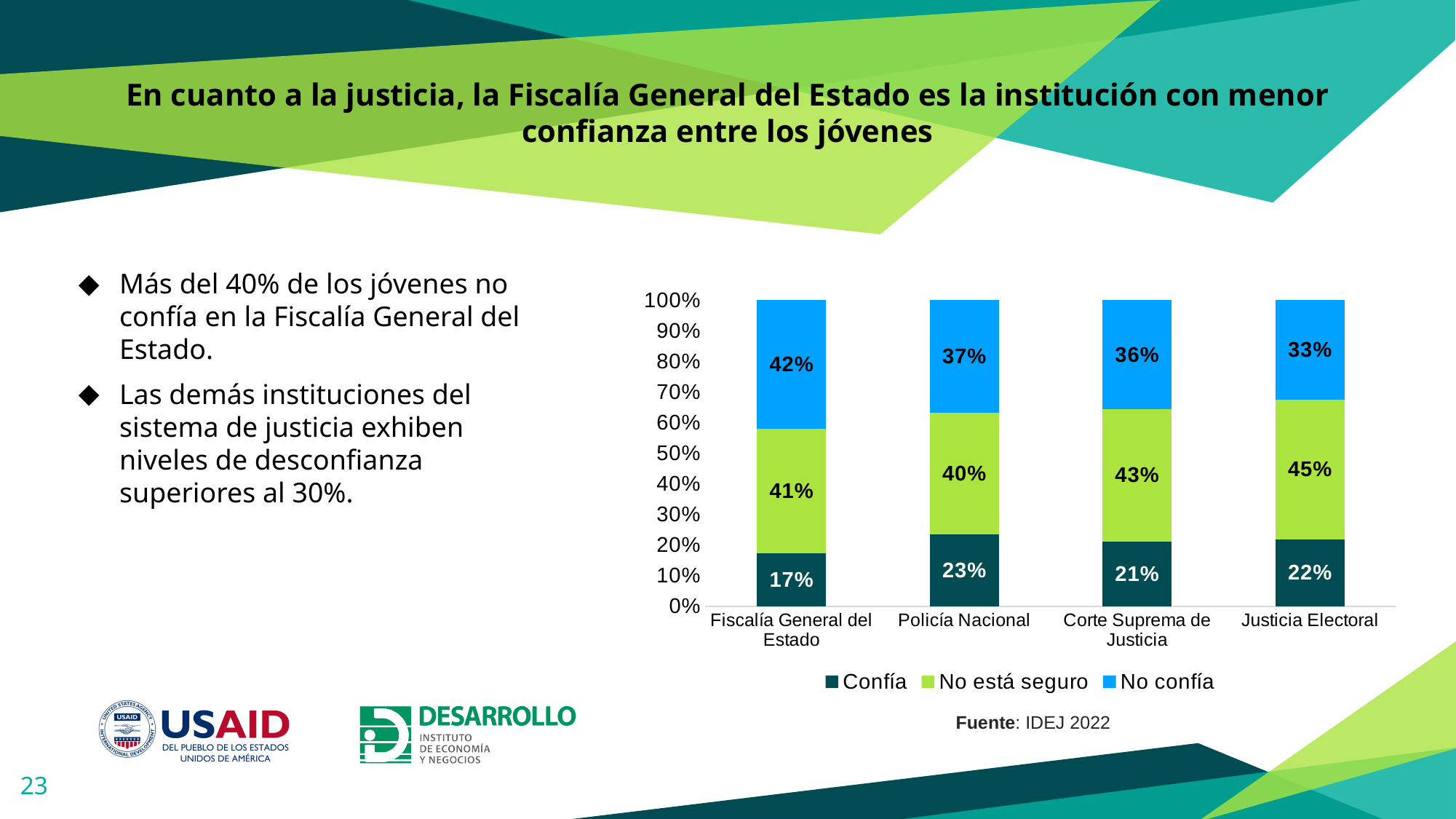
What is the 'No confía' value for Fiscalía General del Estado? 42% What is the 'No está seguro' value for Justicia Electoral? 45% What is the 'No confía' value for Corte Suprema de Justicia? 36% What is the 'Confía' value for Policía Nacional? 23% What source is cited below the chart? IDEJ 2022 Which institution has the highest 'No confía' value? Fiscalía General del Estado Which is larger: the 'No está seguro' value for Policía Nacional or for Corte Suprema de Justicia? Corte Suprema de Justicia What kind of chart is shown on the slide? Stacked bar chart Which institution has the lowest 'Confía' value? Fiscalía General del Estado How many series does the legend list? 3 What is the difference between the 'No confía' values for Fiscalía General del Estado and Justicia Electoral? 9% How many institutions are shown on the x axis? 4